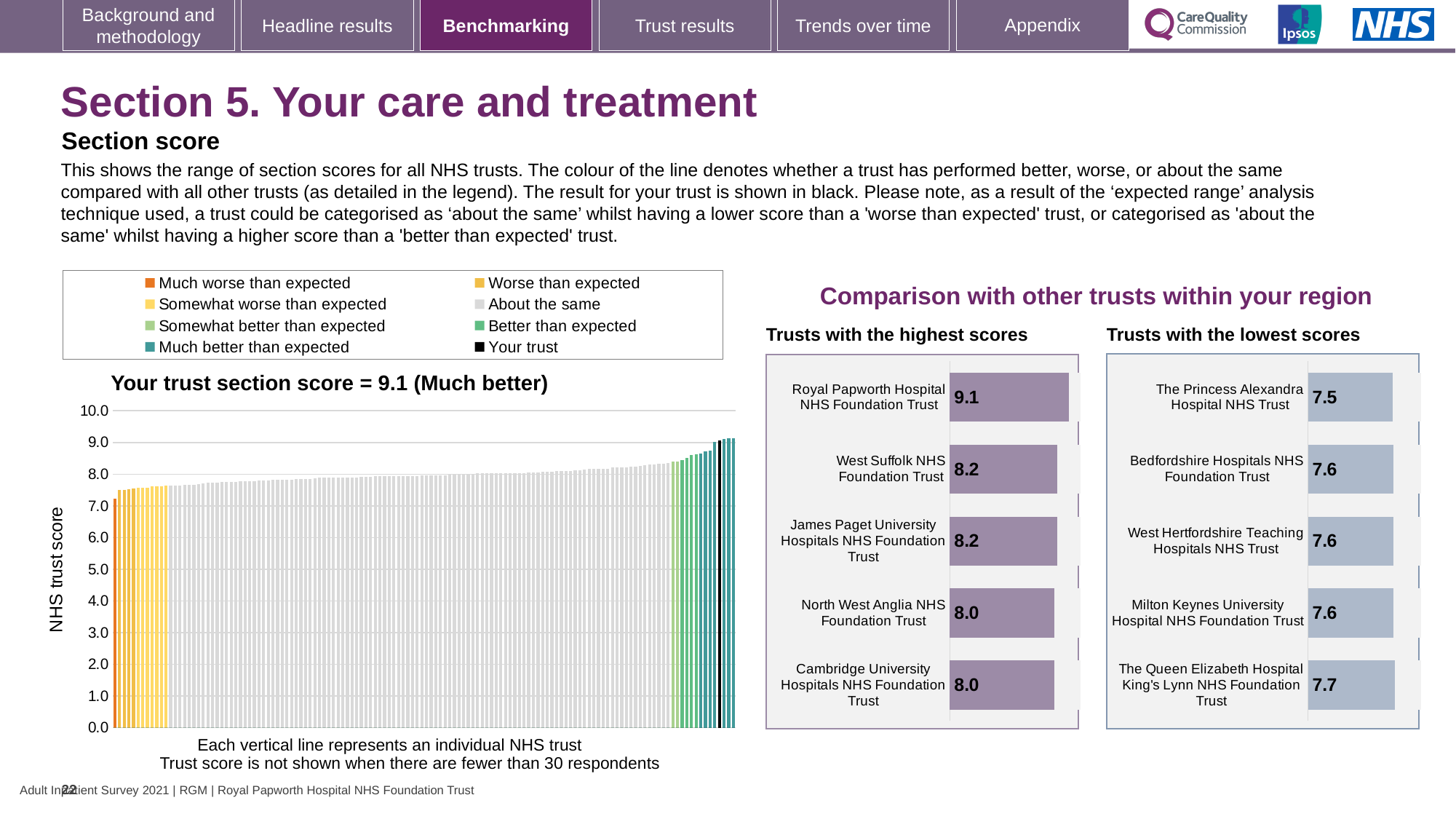
In the 'Trusts with the lowest scores' chart, which trust has the lowest score? The Princess Alexandra Hospital NHS Trust In the 'Trusts with the lowest scores' chart, how many trusts are shown? 5 In the 'Trusts with the lowest scores' chart, what is the score for The Queen Elizabeth Hospital King's Lynn NHS Foundation Trust? 7.7 In the main section score chart on the left, what is the section score for your trust as stated in the chart title? 9.1 In the 'Trusts with the lowest scores' chart, what is the score for The Princess Alexandra Hospital NHS Trust? 7.5 In the main section score chart on the left, how many entries does the legend list? 8 In the 'Trusts with the highest scores' chart, what is the score for North West Anglia NHS Foundation Trust? 8.0 In the 'Trusts with the highest scores' chart, what is the difference between the scores of Royal Papworth Hospital NHS Foundation Trust and West Suffolk NHS Foundation Trust? 0.9 In the 'Trusts with the highest scores' chart, what is the score for Royal Papworth Hospital NHS Foundation Trust? 9.1 In the main section score chart on the left, do the trust scores rise or fall from left to right along the x axis? Rise In the 'Trusts with the highest scores' chart, which trust has the highest score? Royal Papworth Hospital NHS Foundation Trust What kind of chart is the 'Trusts with the highest scores' chart? Bar chart